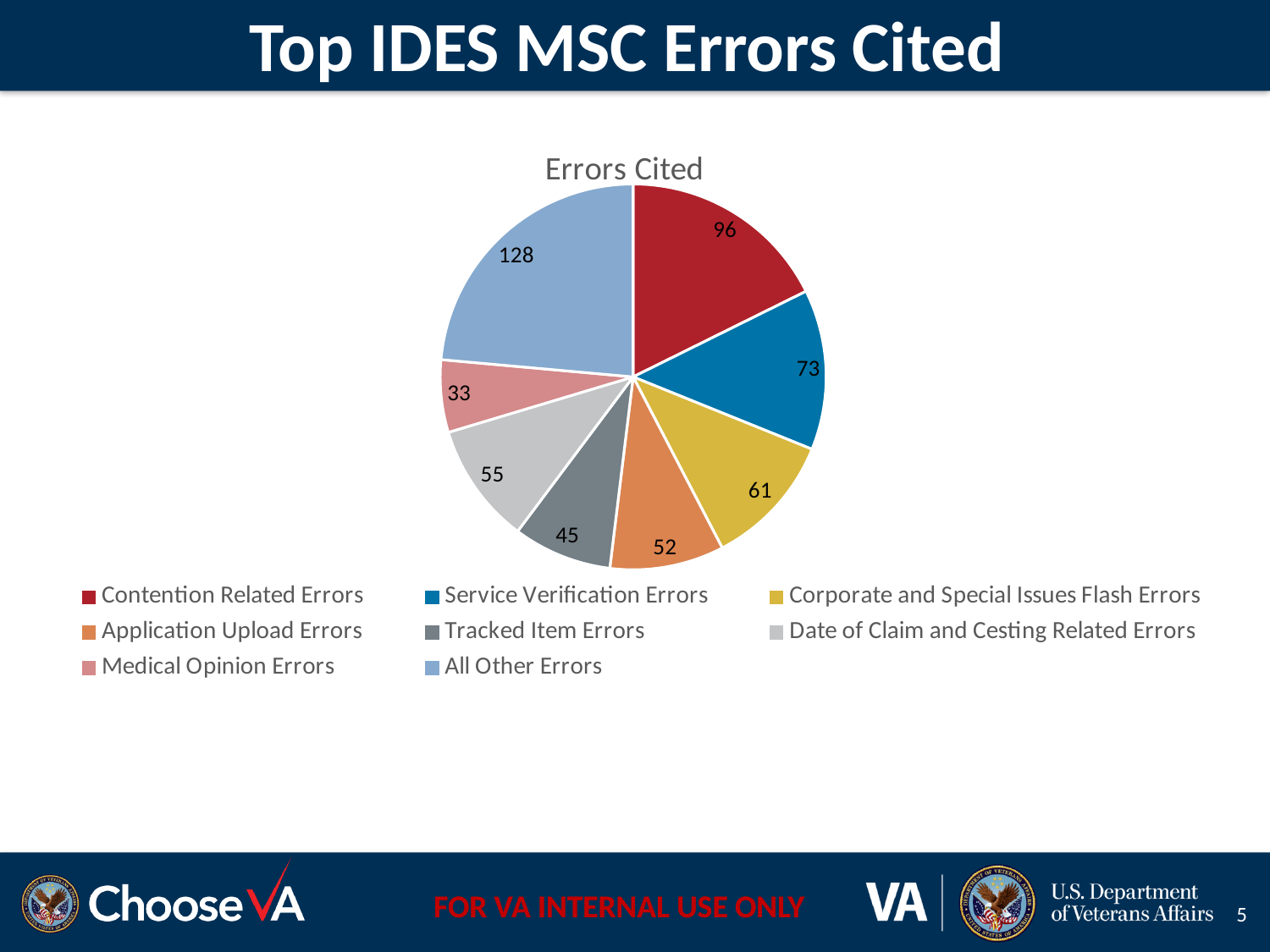
Which is larger, Corporate and Special Issues Flash Errors or Date of Claim and Cesting Related Errors? Corporate and Special Issues Flash Errors What is the value for Medical Opinion Errors? 33 What is the value for Contention Related Errors? 96 Which category has the smallest slice of the pie? Medical Opinion Errors Which category has the largest slice of the pie? All Other Errors What colour is the slice for Application Upload Errors? Orange What is the value for Service Verification Errors? 73 What type of chart is shown on the slide? Pie chart What is the value for Tracked Item Errors? 45 What is the title of the chart? Errors Cited What is the difference between All Other Errors and Contention Related Errors? 32 How many error categories are shown in the pie chart? 8